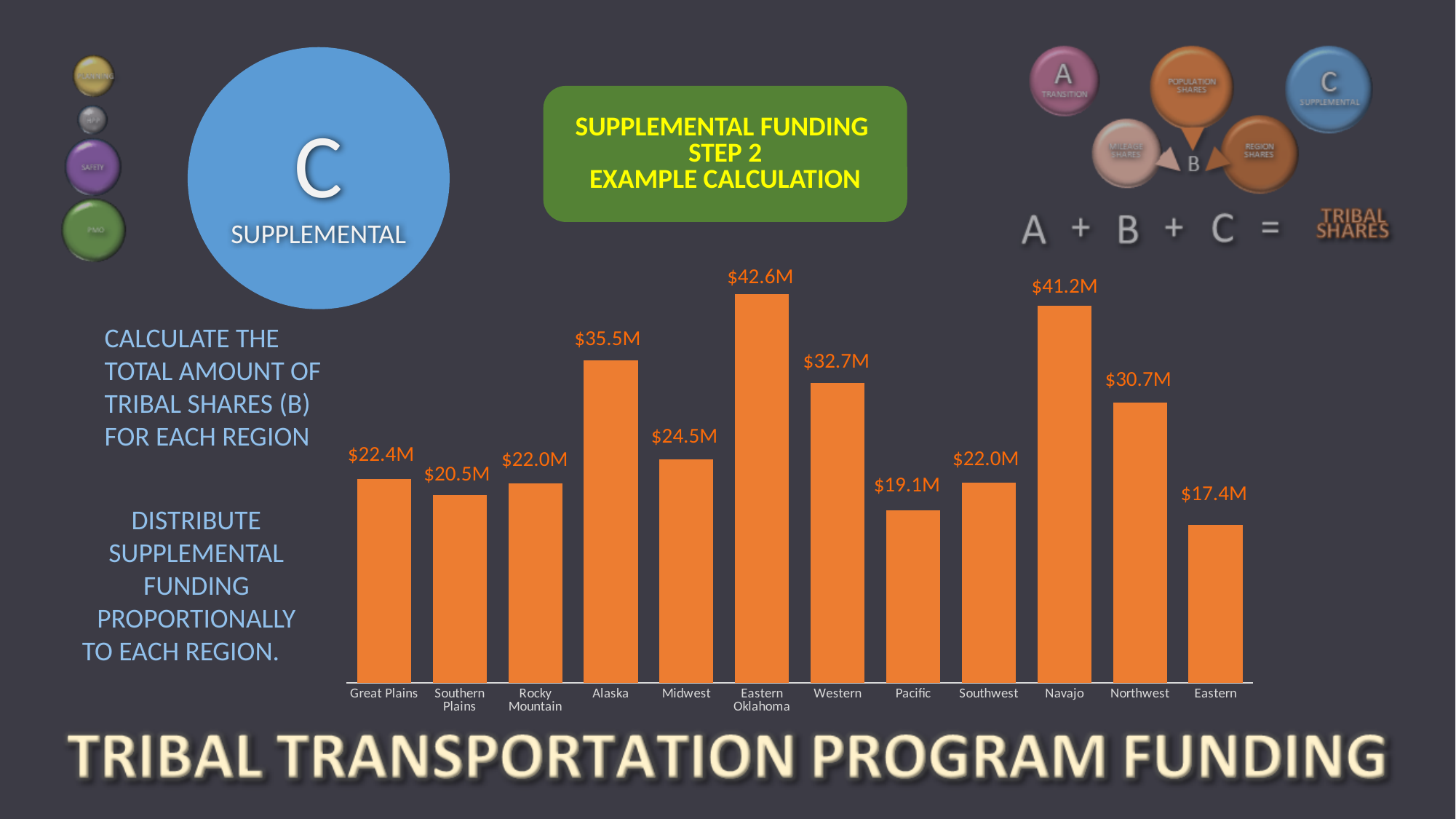
What is the value for Eastern Oklahoma? $42.6M Which is larger, the value for Alaska or the value for Western? Alaska Which is larger, the value for Northwest or the value for Midwest? Northwest How many regions are shown in the chart? 12 What is the value for Pacific? $19.1M Which region has the highest value? Eastern Oklahoma What is the difference between the values for Eastern Oklahoma and Navajo? $1.4M What is the difference between the values for Alaska and Midwest? $11.0M Which region has the lowest value? Eastern What kind of chart is shown on the slide? Bar chart What is the value for Navajo? $41.2M What is the value for Southern Plains? $20.5M